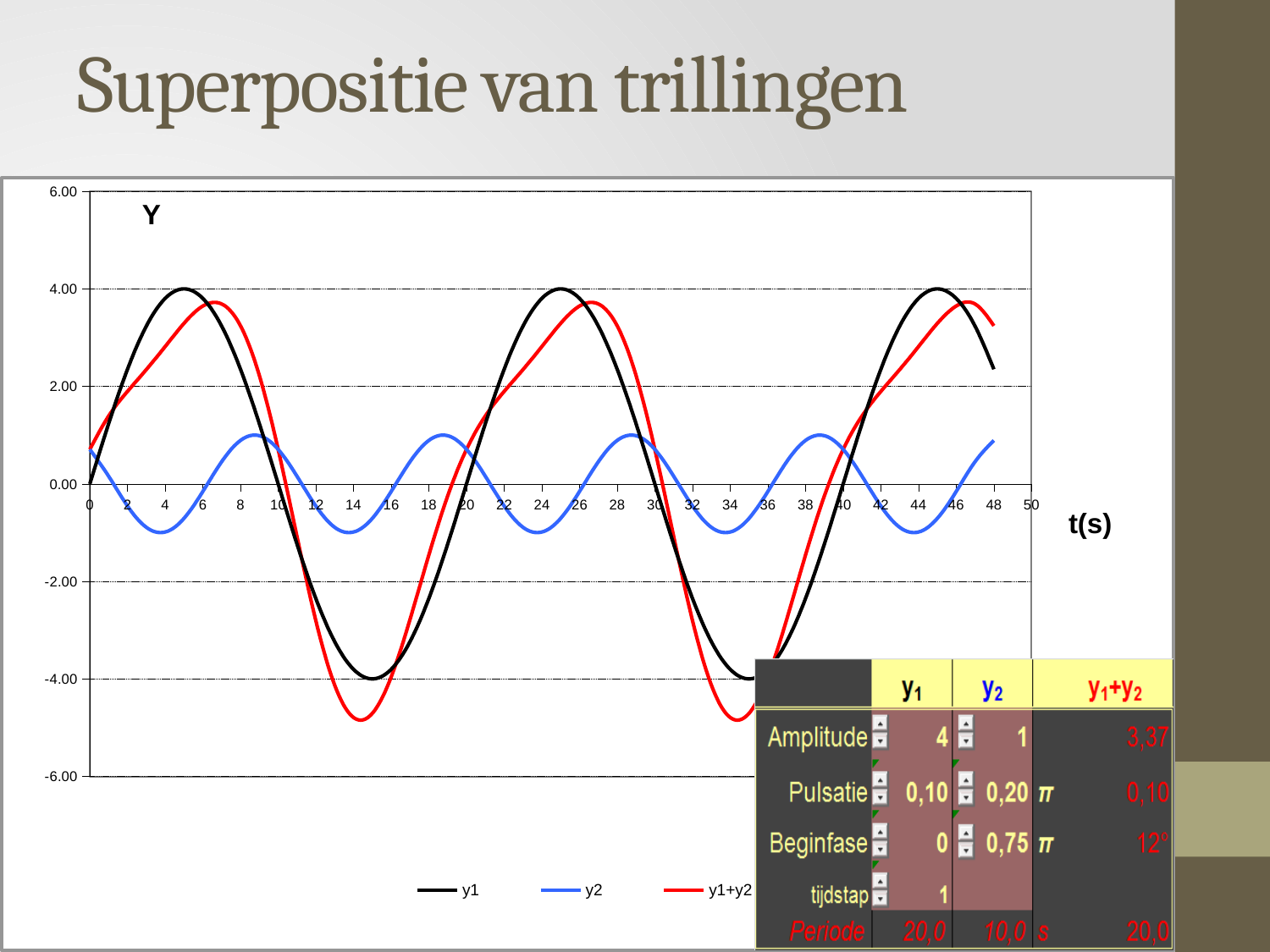
How many series does the chart legend list? 3 Is the value of y2 at t = 14 greater or less than 0.00? less Is the value of y1+y2 at t = 14 greater or less than -4.00? less Is the value of y1 at t = 25 greater or less than 2.00? greater Which series reaches the lowest value on the chart? y1+y2 Does the y1 series rise or fall between t = 0 and t = 5? rise At t = 5, which series has the larger value, y1 or y2? y1 Which series reaches the highest value on the chart? y1 What are the series names listed in the chart legend? y1, y2, y1+y2 What is the label on the horizontal axis of the chart? t(s) Does the y2 series rise or fall between t = 0 and t = 4? fall What kind of chart is shown on the slide? line chart